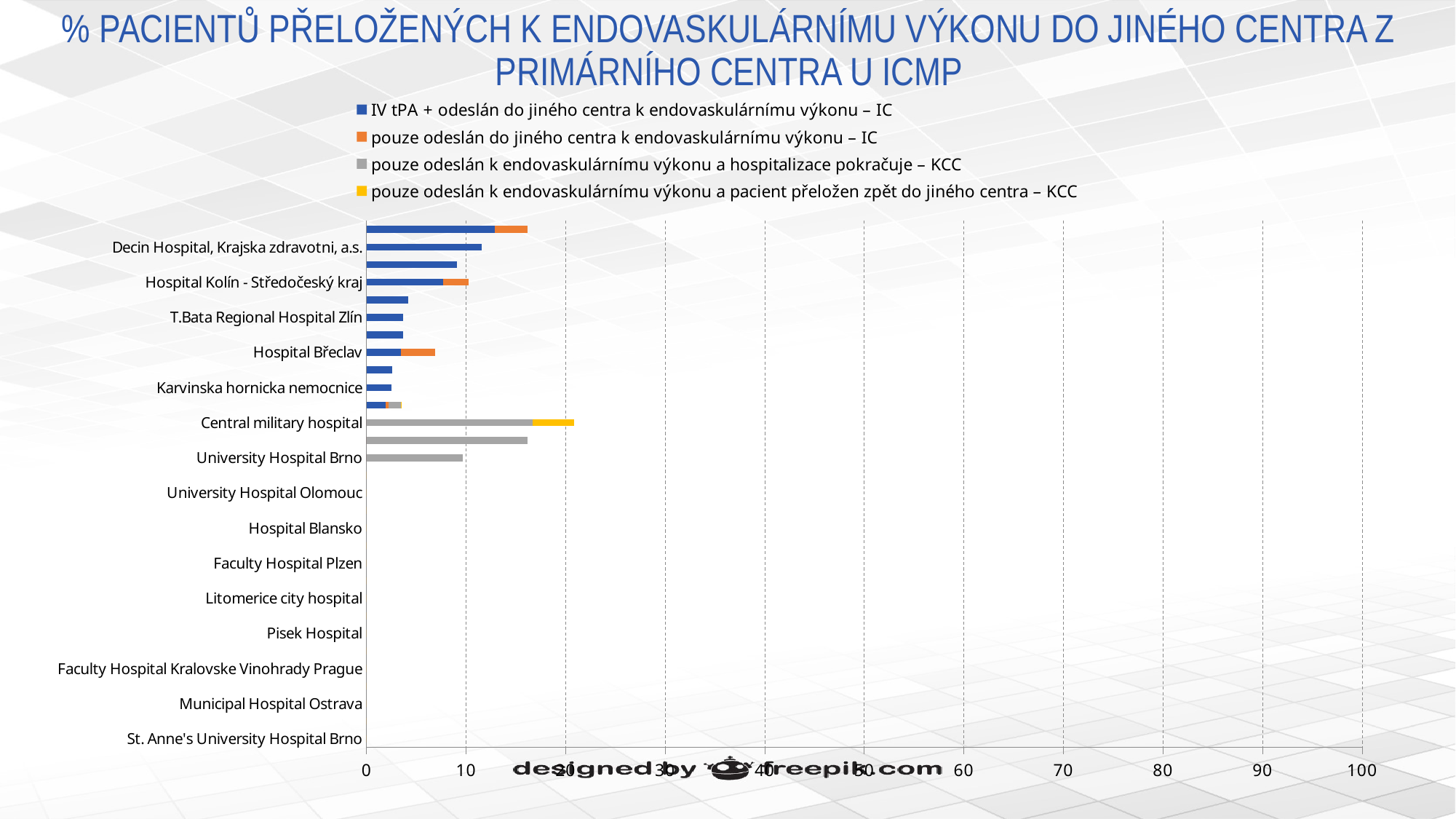
Which colour represents the series 'pouze odeslán k endovaskulárnímu výkonu a pacient přeložen zpět do jiného centra – KCC'? yellow Is the value for Karvinska hornicka nemocnice greater or less than 10? less Which has a larger value, Decin Hospital, Krajska zdravotni, a.s. or T.Bata Regional Hospital Zlín? Decin Hospital, Krajska zdravotni, a.s. Is the value for T.Bata Regional Hospital Zlín greater or less than 10? less Is the value for Central military hospital greater or less than 10? greater What is the maximum value shown on the horizontal axis? 100 How many series does the legend list? 4 Which has a larger value, Central military hospital or University Hospital Brno? Central military hospital Which labeled hospital has the longest bar? Central military hospital What kind of chart is shown on the slide? bar chart